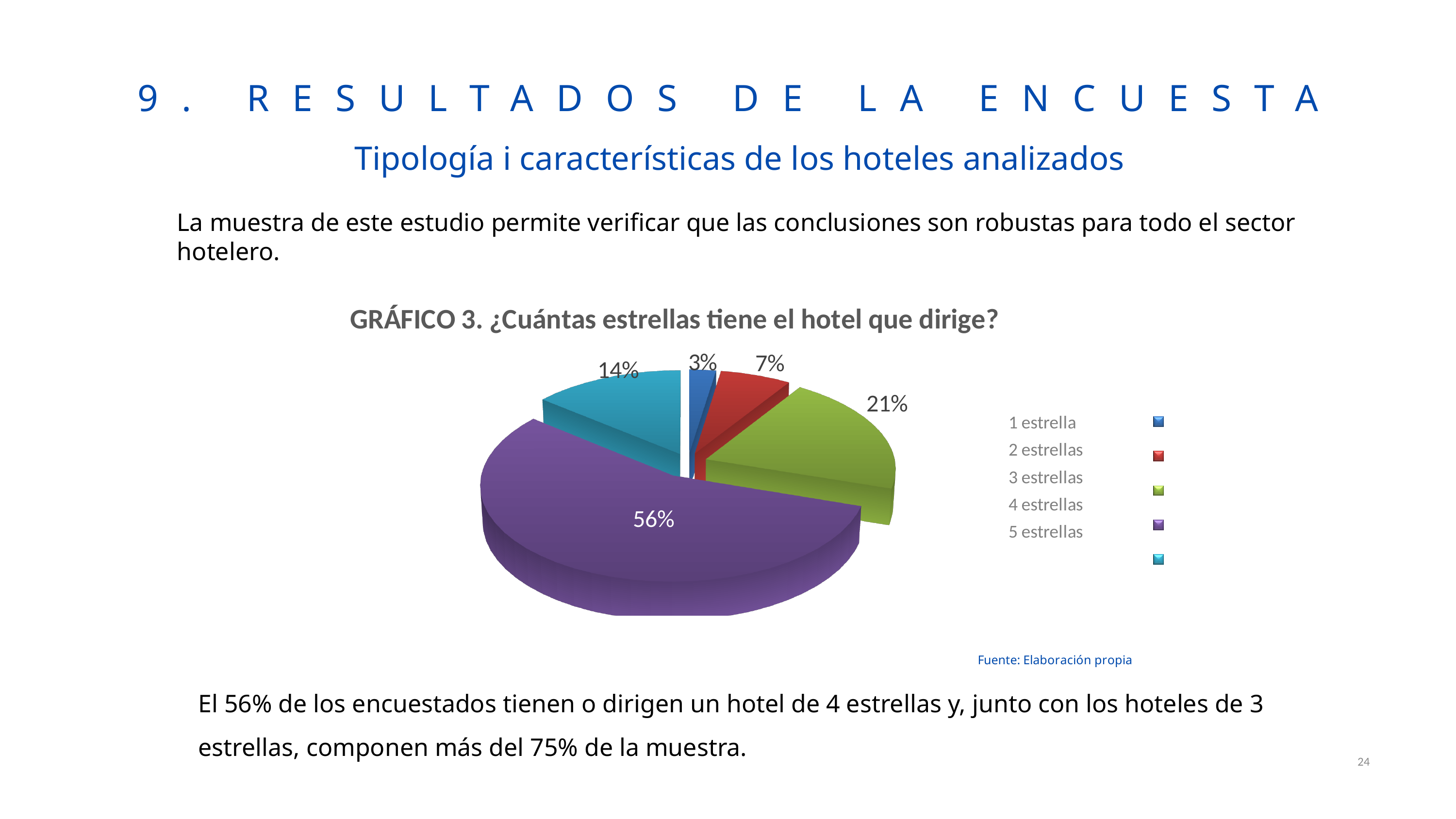
Which category has the smallest slice in the pie chart? 1 estrella What percentage of the pie chart corresponds to 4 estrellas? 56% Which slice is larger: 5 estrellas or 2 estrellas? 5 estrellas Which category has the largest slice in the pie chart? 4 estrellas What percentage does the 1 estrella slice show? 3% What percentage does the 2 estrellas slice show? 7% What type of chart is shown on the slide? Pie chart What is the title of the chart? GRÁFICO 3. ¿Cuántas estrellas tiene el hotel que dirige? How many slices does the pie chart have? 5 What share of the pie chart is labelled for 3 estrellas? 21% What percentage does the 5 estrellas slice show? 14% How many percentage points larger is the 4 estrellas slice than the 3 estrellas slice? 35 percentage points